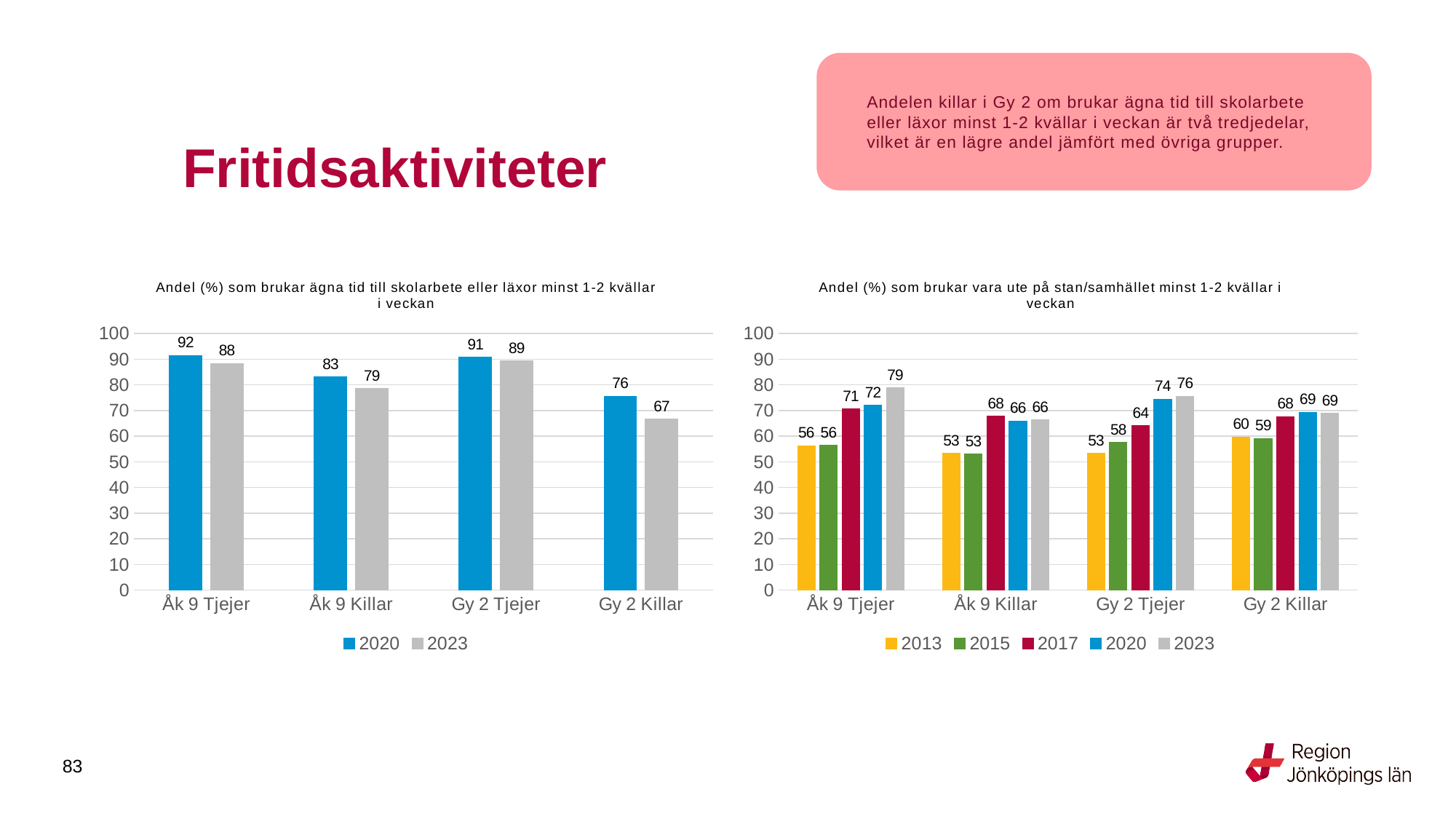
In the left chart (skolarbete eller läxor), how many series does the legend list? 2 In the left chart (skolarbete eller läxor), what is the value for Åk 9 Killar in 2023? 79 In the right chart (ute på stan/samhället), what is the value for Gy 2 Tjejer in 2017? 64 In the right chart (ute på stan/samhället), is the 2013 value for Åk 9 Killar larger or smaller than the 2013 value for Gy 2 Killar? smaller What kind of chart is the right chart (ute på stan/samhället)? bar chart In the left chart (skolarbete eller läxor), what is the difference between the 2020 and 2023 values for Gy 2 Killar? 9 How many categories are shown on the x axis of the left chart (skolarbete eller läxor)? 4 In the left chart (skolarbete eller läxor), which category has the lowest value for 2023? Gy 2 Killar In the right chart (ute på stan/samhället), what is the difference between the 2023 and 2013 values for Åk 9 Tjejer? 23 In the right chart (ute på stan/samhället), which category has the highest value for 2023? Åk 9 Tjejer In the right chart (ute på stan/samhället), how many series does the legend list? 5 In the left chart (skolarbete eller läxor), which category has the highest value for 2020? Åk 9 Tjejer